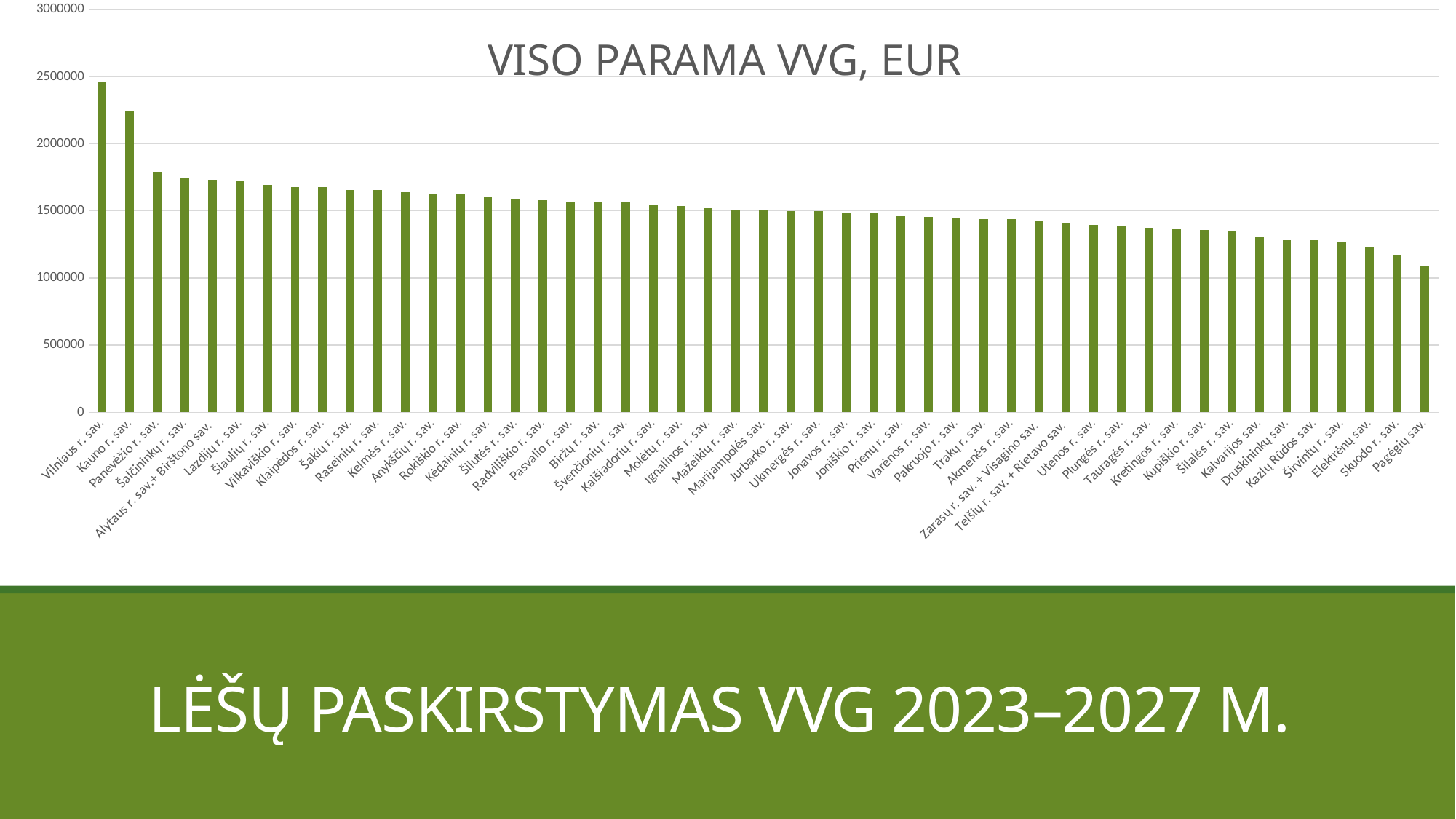
Do the values rise or fall from left to right along the x axis? fall Is the value for Skuodo r. sav. greater or less than 1000000? greater Is the value for Vilniaus r. sav. greater or less than 2000000? greater Is the value for Utenos r. sav. greater or less than 1500000? less Which category has the lowest value in the chart? Pagėgių sav. Which is larger, the value for Kalvarijos sav. or the value for Šilutės r. sav.? Šilutės r. sav. Which category has the highest value in the chart? Vilniaus r. sav. What is the title of the chart? VISO PARAMA VVG, EUR What kind of chart is shown on the slide? bar chart Which is larger, the value for Vilniaus r. sav. or the value for Kauno r. sav.? Vilniaus r. sav.